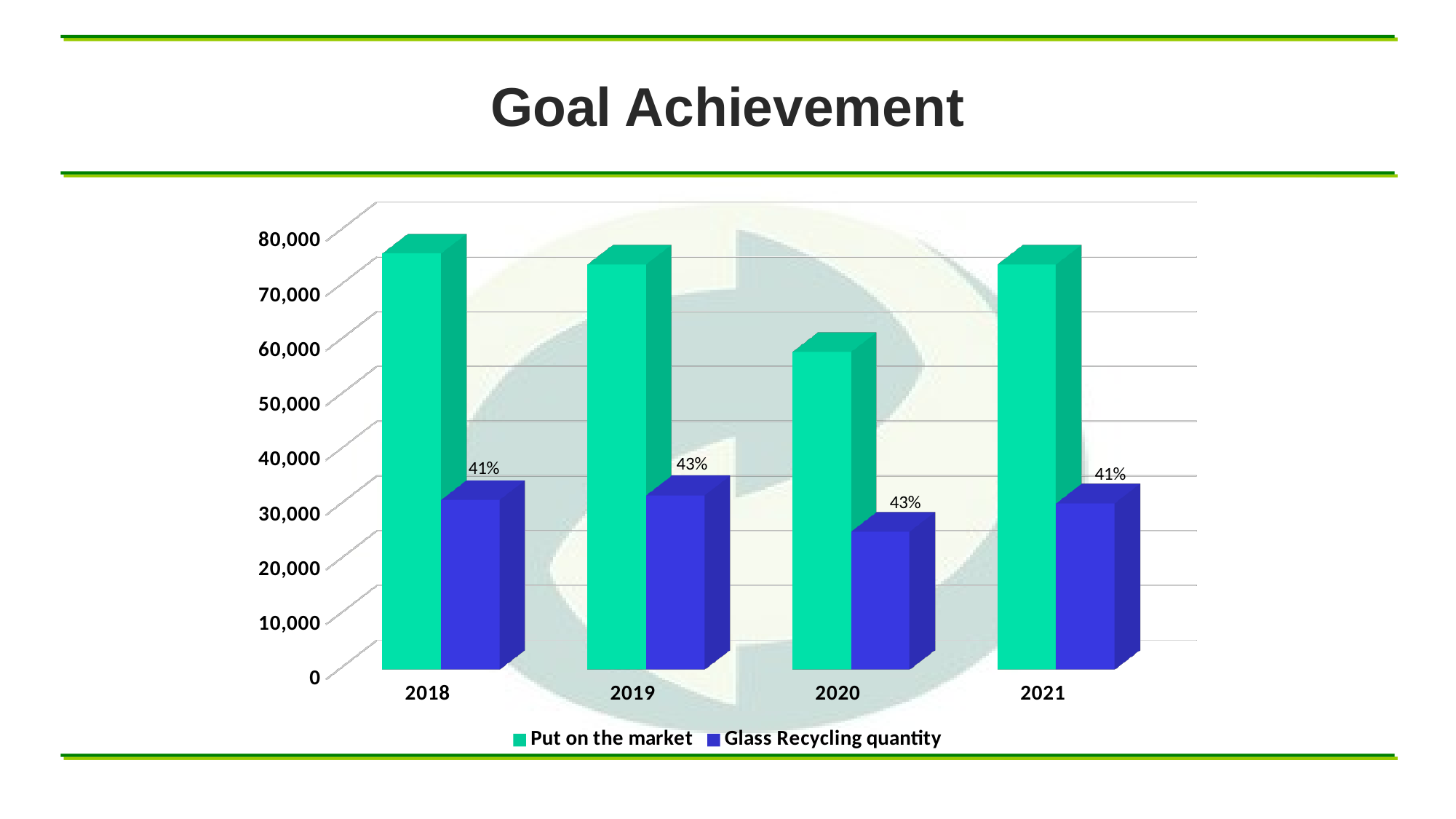
What percentage label is shown on the Glass Recycling quantity bar for 2018? 41% In which year is the Glass Recycling quantity lowest? 2020 Is the Put on the market value for 2020 greater or less than 50,000? greater What percentage label is shown on the Glass Recycling quantity bar for 2019? 43% In which year is the Put on the market value lowest? 2020 Is the Glass Recycling quantity for 2020 greater or less than 30,000? less What is the title of the slide containing the chart? Goal Achievement What percentage label is shown on the Glass Recycling quantity bar for 2021? 41% Which is larger in 2018: Put on the market or Glass Recycling quantity? Put on the market How many years are shown on the x axis? 4 Is the Put on the market value for 2018 greater or less than 70,000? greater How many series does the legend list? 2